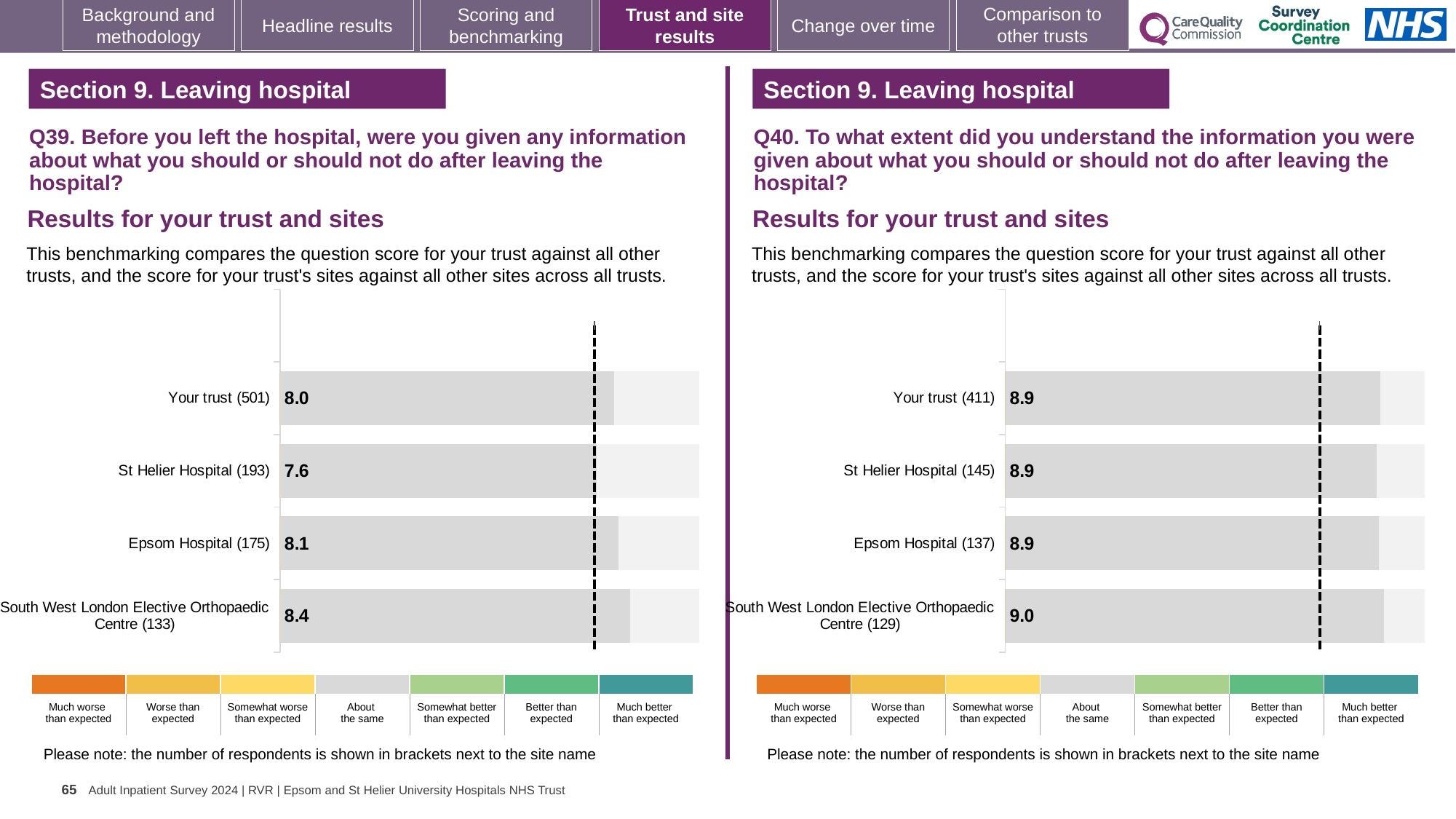
In the Q40 chart on the right, what is the score for Epsom Hospital (137)? 8.9 In the Q39 chart on the left, what is the difference between the scores for South West London Elective Orthopaedic Centre (133) and St Helier Hospital (193)? 0.8 In the Q39 chart on the left, what is the score for St Helier Hospital (193)? 7.6 In the Q40 chart on the right, what is the difference between the scores for South West London Elective Orthopaedic Centre (129) and Your trust (411)? 0.1 In the Q39 chart on the left, which site has the highest score? South West London Elective Orthopaedic Centre (133) How many categories does the colour key below the Q39 chart on the left list? 7 In the Q39 chart on the left, which has the higher score, Epsom Hospital (175) or St Helier Hospital (193)? Epsom Hospital (175) In the Q39 chart on the left, what is the score for Your trust (501)? 8.0 In the Q39 chart on the left, which site has the lowest score? St Helier Hospital (193) How many bars are plotted in the Q39 chart on the left? 4 In the Q40 chart on the right, what is the score for South West London Elective Orthopaedic Centre (129)? 9.0 What type of chart is used in the Q40 chart on the right? Bar chart